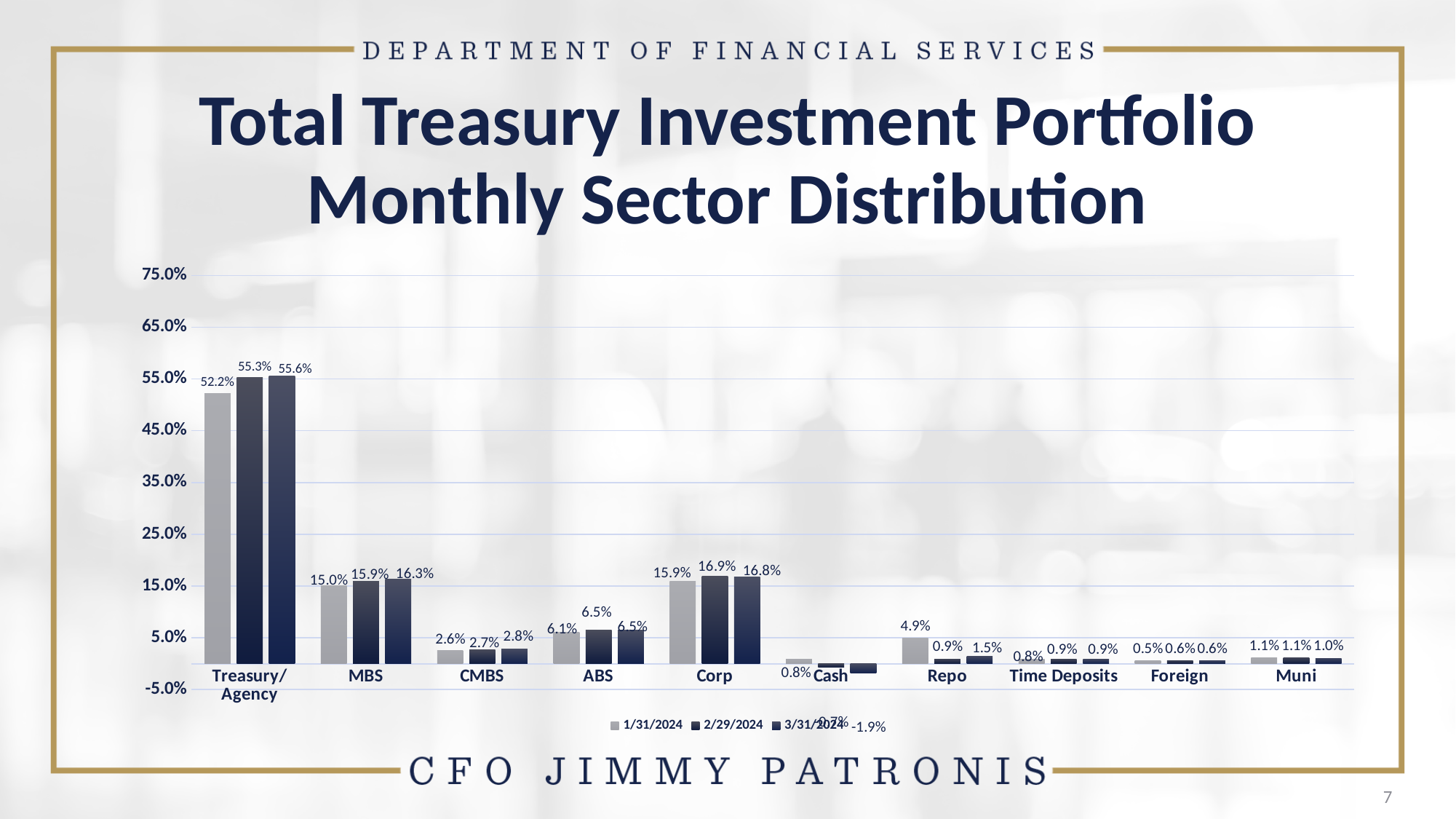
What is the value for Repo for 1/31/2024? 4.9% Which sector has the highest value for 1/31/2024? Treasury/Agency What is the value for Corp for 2/29/2024? 16.9% What is the title of the chart? Total Treasury Investment Portfolio Monthly Sector Distribution What is the value for Treasury/Agency for 3/31/2024? 55.6% What type of chart is shown on the slide? bar chart How many sector categories are shown on the x axis? 10 Is the value for MBS for 2/29/2024 greater or less than 15.0%? greater Which sector has the lowest value for 3/31/2024? Cash What is the difference between the Treasury/Agency values for 3/31/2024 and 1/31/2024? 3.4% Which is larger for 3/31/2024: MBS or Corp? Corp How many series does the legend list? 3